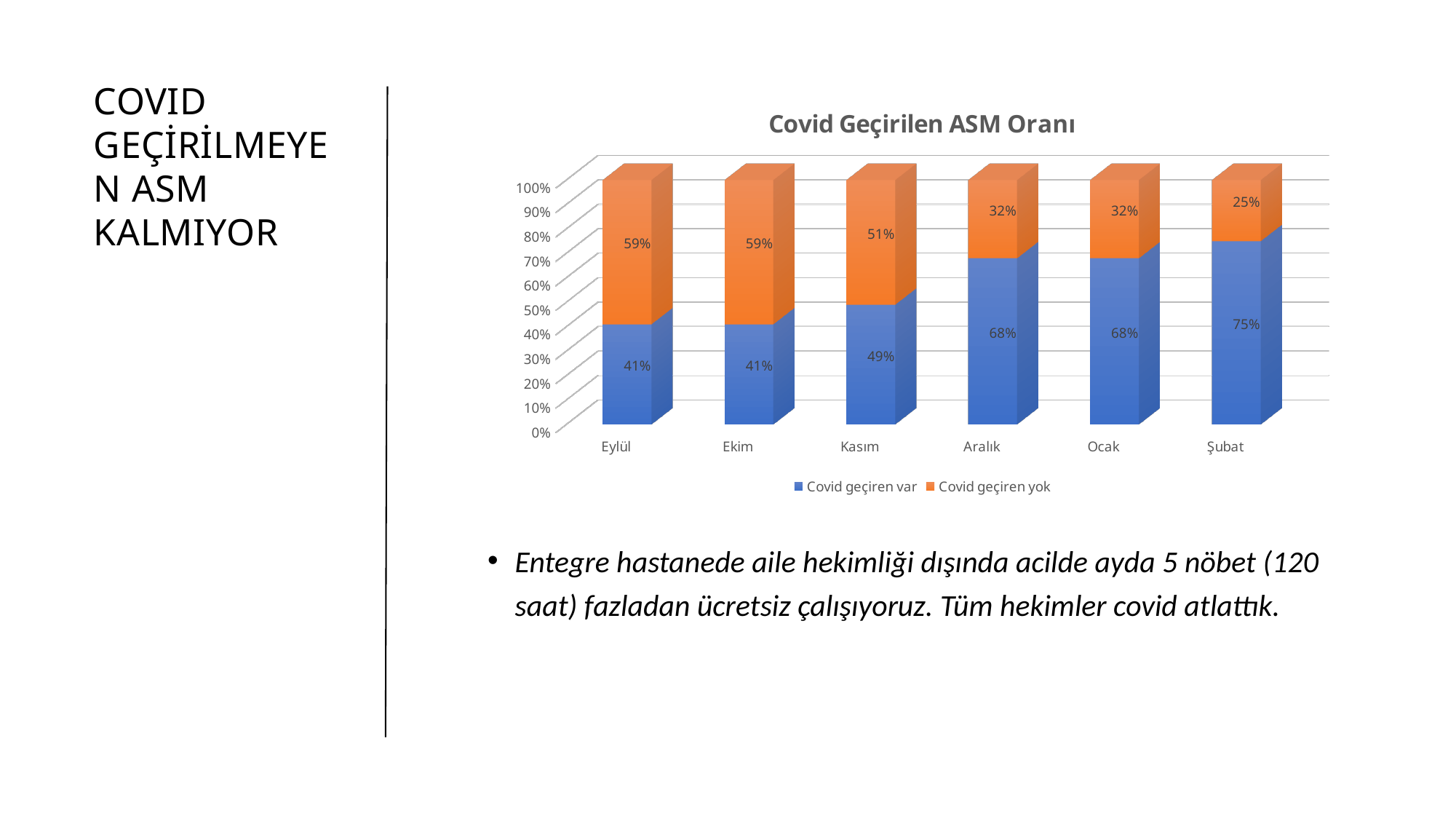
How many series does the legend list? 2 What is the value of "Covid geçiren yok" for Aralık? 32% What is the value of "Covid geçiren var" for Eylül? 41% How many months are shown on the x axis? 6 Which month has the lowest value for "Covid geçiren yok"? Şubat What is the title of the chart? Covid Geçirilen ASM Oranı What is the value of "Covid geçiren yok" for Kasım? 51% Which month has the highest value for "Covid geçiren var"? Şubat What is the difference between the "Covid geçiren var" values for Şubat and Eylül? 34% What is the value of "Covid geçiren var" for Şubat? 75% Which is larger: "Covid geçiren var" for Kasım or "Covid geçiren var" for Aralık? Aralık What kind of chart is shown on the slide? Stacked bar chart